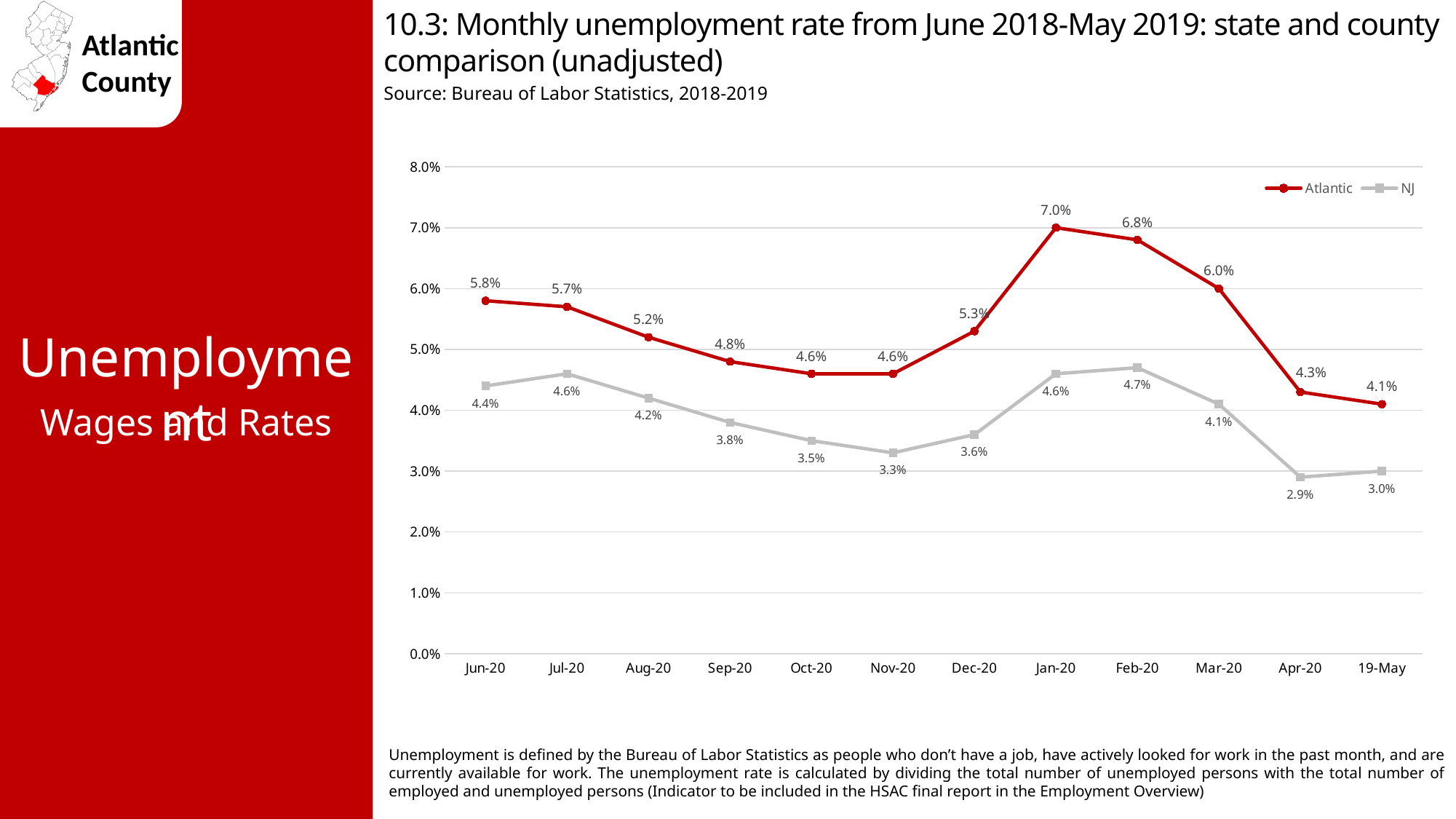
In which month does the NJ series reach its lowest value? Apr-20 How many series does the legend list? 2 What is the source cited for the chart? Bureau of Labor Statistics, 2018-2019 Does the Atlantic series rise or fall from Jan-20 to 19-May? Fall How many months are plotted on the x axis? 12 What is the NJ unemployment rate for Nov-20? 3.3% Which series has the higher value in Feb-20, Atlantic or NJ? Atlantic What is the Atlantic unemployment rate for Jan-20? 7.0% What is the Atlantic unemployment rate for 19-May? 4.1% What kind of chart is shown on the slide? Line chart In which month does the Atlantic series reach its highest value? Jan-20 What is the difference between the Atlantic and NJ rates in Jan-20? 2.4%